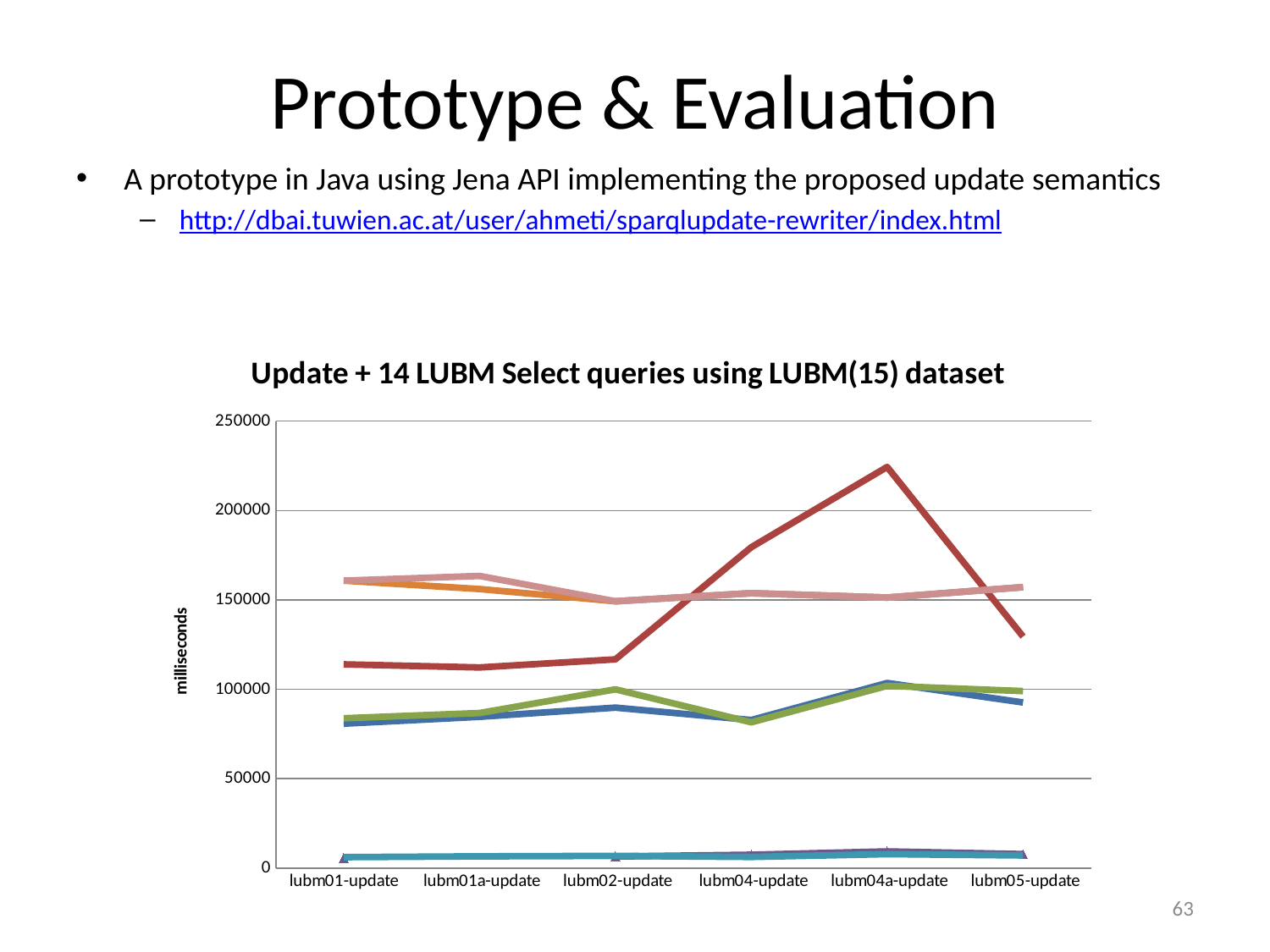
How many categories are shown along the x axis of the chart? 6 Is the value of the dark red line at lubm04a-update greater or less than 200000? greater What is the title of the chart? Update + 14 LUBM Select queries using LUBM(15) dataset Is the value of the blue line at lubm01-update greater or less than 100000? less What is the label on the vertical axis of the chart? milliseconds At lubm04a-update, which line has the larger value, the dark red line or the pink line? the dark red line At which category does the dark red line reach its highest value? lubm04a-update Is the value of the dark red line at lubm05-update greater or less than 150000? less Does the dark red line rise or fall from lubm02-update to lubm04a-update? rise What kind of chart is shown on the slide? line chart